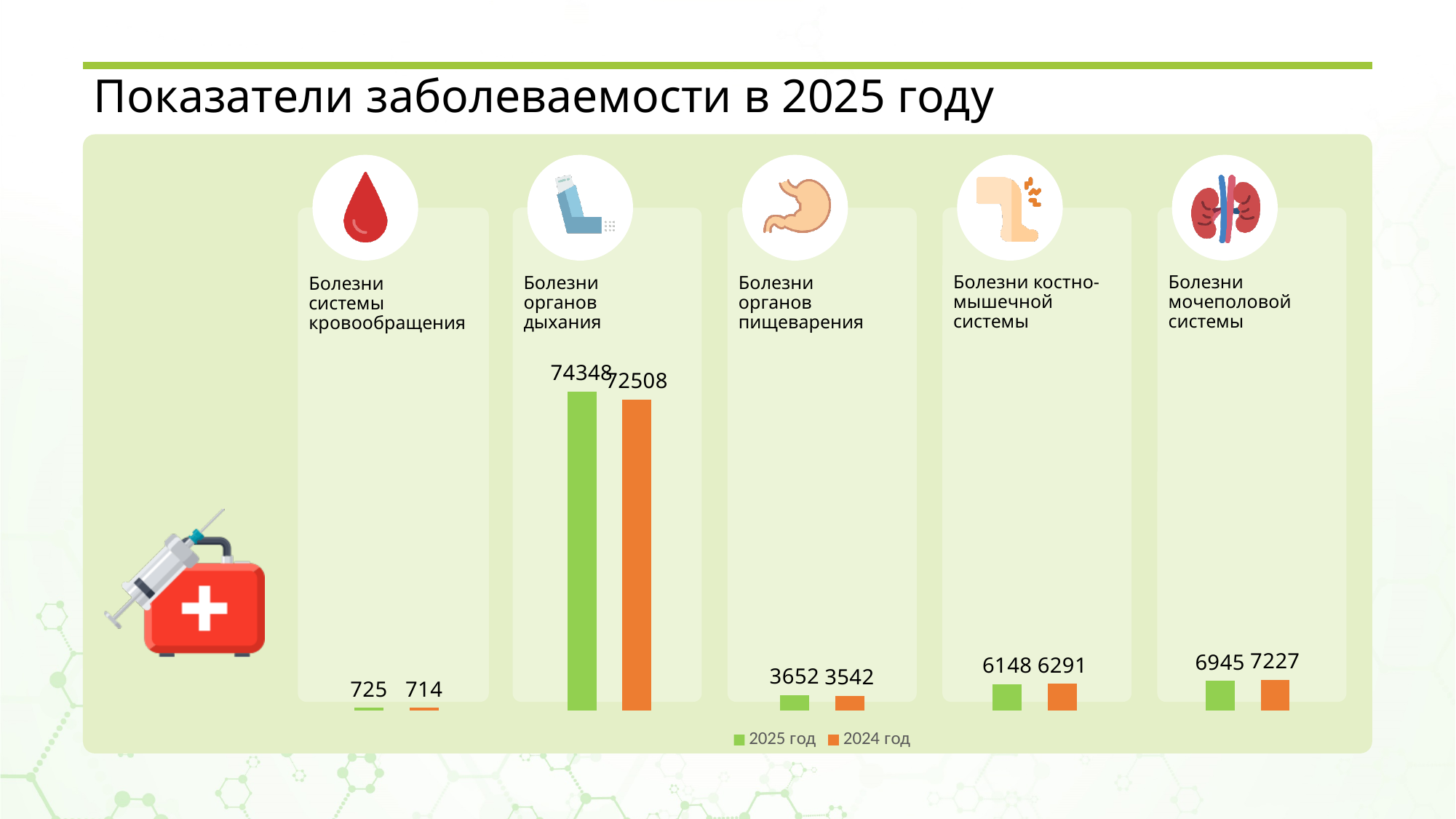
What is the 2025 год value for Болезни системы кровообращения? 725 How many series does the legend list? 2 What is the difference between the 2024 год and 2025 год values for Болезни костно-мышечной системы? 143 Which category has the highest 2025 год value? Болезни органов дыхания Which category has the lowest 2024 год value? Болезни системы кровообращения What type of chart is shown on the slide? Bar chart What is the 2025 год value for Болезни органов дыхания? 74348 What is the 2024 год value for Болезни органов пищеварения? 3542 For Болезни мочеполовой системы, which is larger: the 2025 год value or the 2024 год value? 2024 год What is the difference between the 2025 год and 2024 год values for Болезни органов дыхания? 1840 What is the 2024 год value for Болезни мочеполовой системы? 7227 How many disease categories are shown in the chart? 5